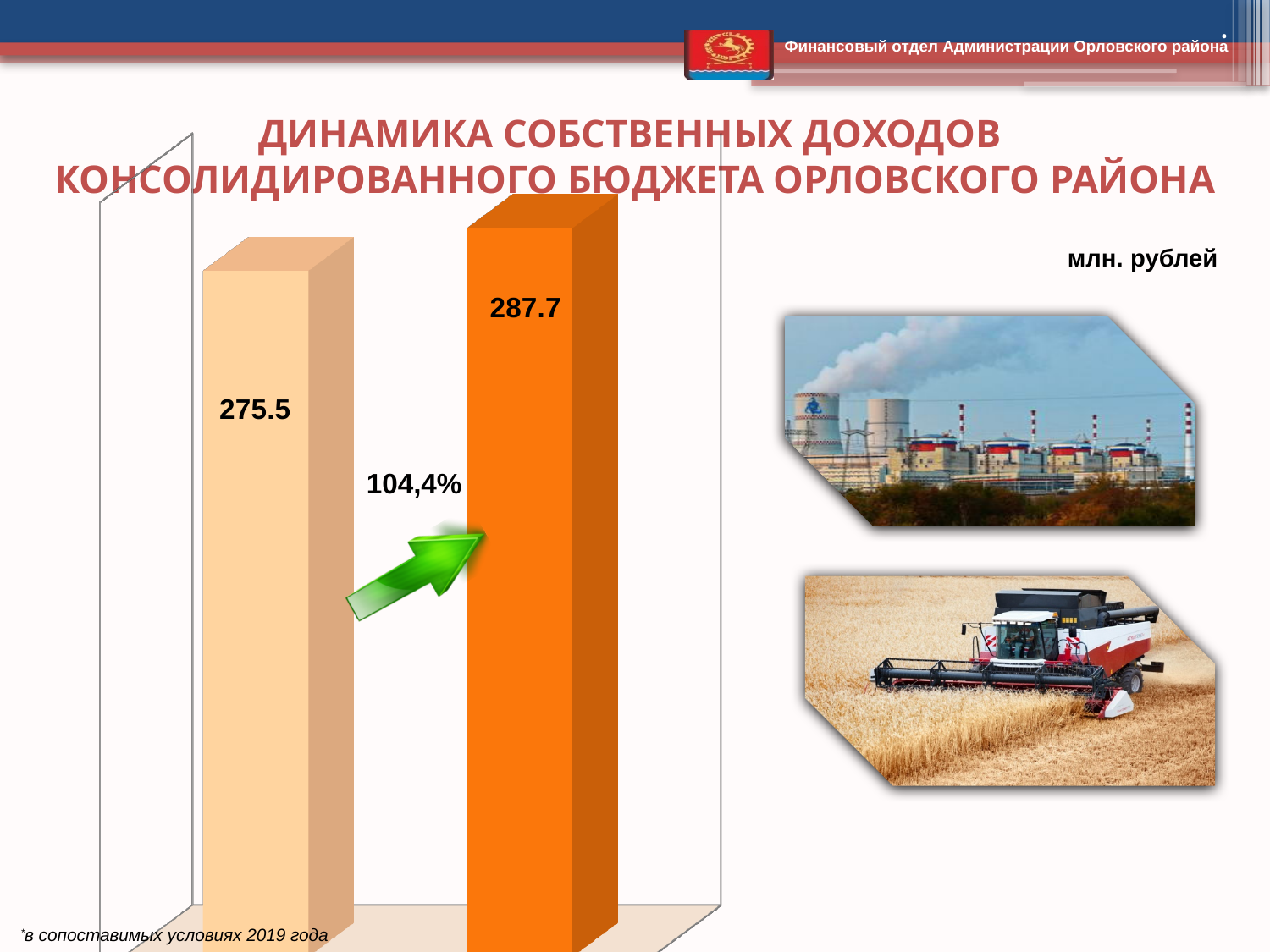
Which bar has the higher value, the left one or the right one? the right one How many bars are plotted in the chart? 2 What value is shown on the right (dark orange) bar of the chart? 287.7 Which bar has the lower value, the left one or the right one? the left one Is the value of the right bar larger or smaller than the value of the left bar? larger What kind of chart is shown on the slide? bar chart What value is shown on the left (light orange) bar of the chart? 275.5 In what units are the chart values given, according to the slide? млн. рублей Do the values rise or fall from the left bar to the right bar? rise What is the difference between the values of the right bar and the left bar? 12.2 What growth percentage is printed between the two bars? 104,4%